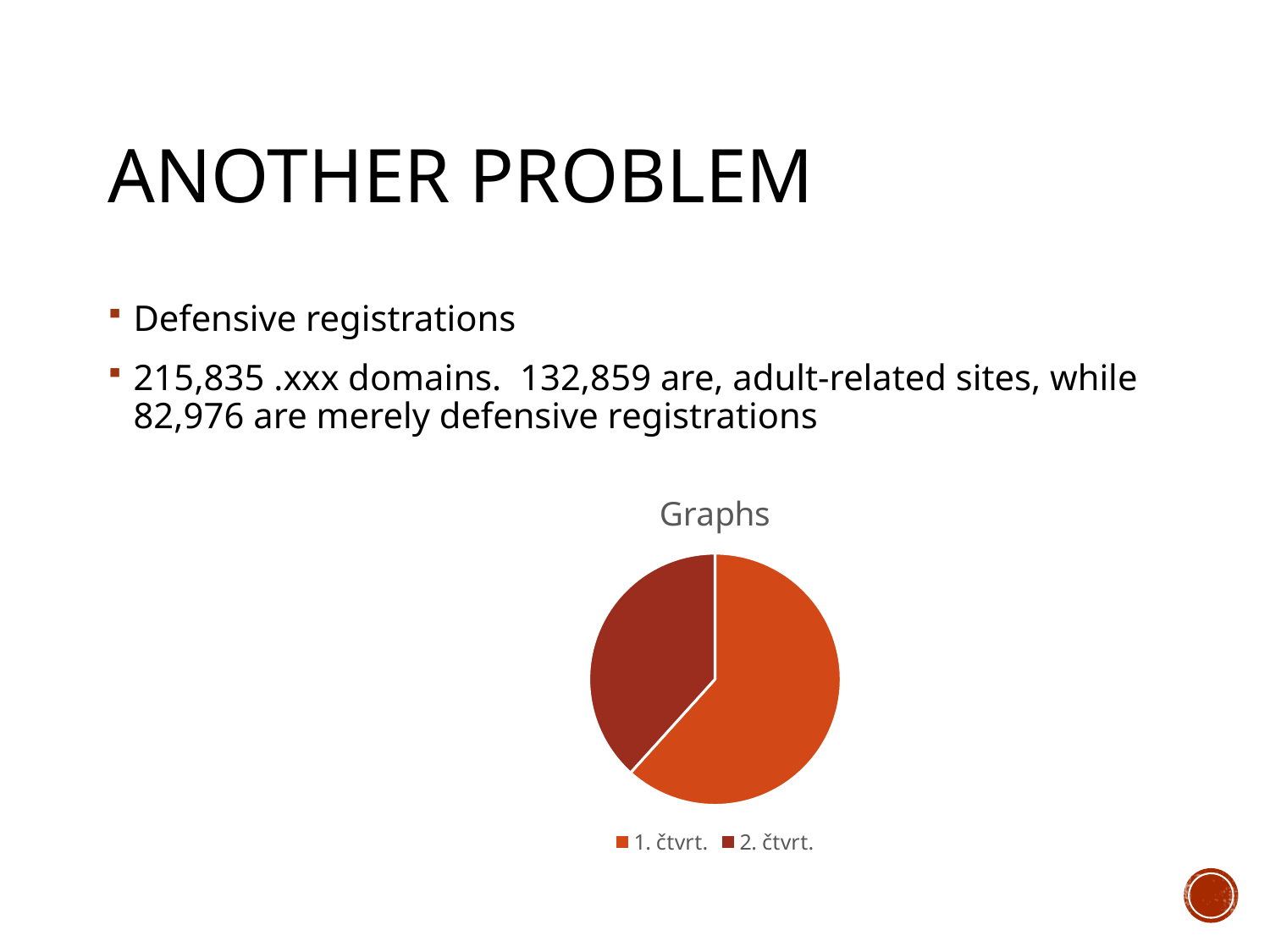
How many slices does the pie chart have? 2 What are the two legend entries of the pie chart? 1. čtvrt. and 2. čtvrt. Which is larger in the pie chart, 1. čtvrt. or 2. čtvrt.? 1. čtvrt. What is the title of the chart? Graphs Which slice of the pie chart is the smallest? 2. čtvrt. Does the 1. čtvrt. slice take up more or less than half of the pie? more Which slice of the pie chart is the largest? 1. čtvrt. What kind of chart is shown on the slide? pie chart How many entries does the chart legend list? 2